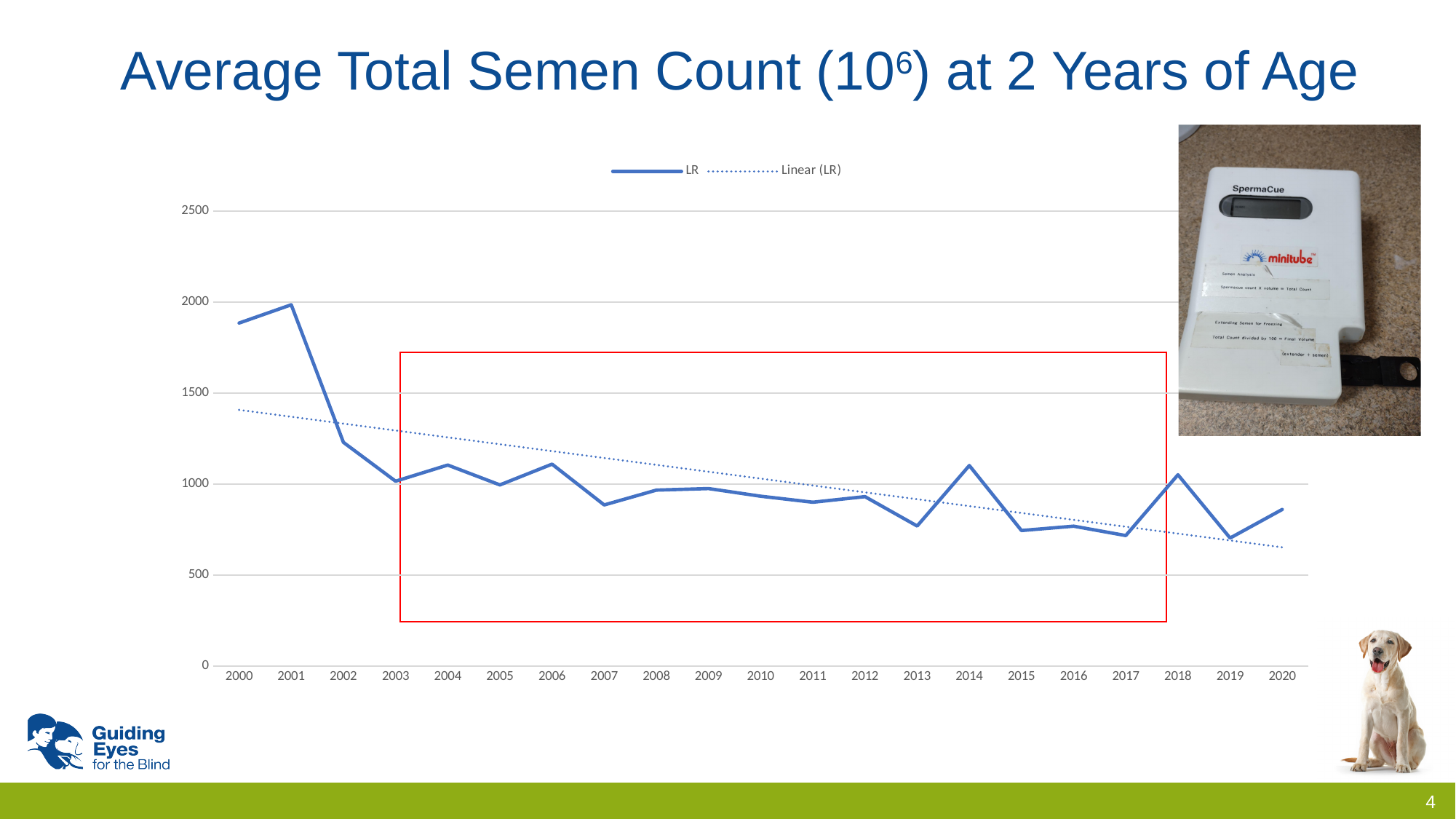
Which is larger, the LR value for 2001 or for 2002? 2001 Is the LR value for 2013 greater or less than 1000? less How many series does the legend list? 2 Which year has the highest LR value? 2001 Is the LR value for 2014 greater or less than 1000? greater What are the two entries in the chart legend? LR and Linear (LR) How many years are plotted along the x axis? 21 Is the LR value for 2002 greater or less than 1500? less Overall, do the LR values rise or fall from 2000 to 2020? fall What kind of chart is shown on the slide? line chart